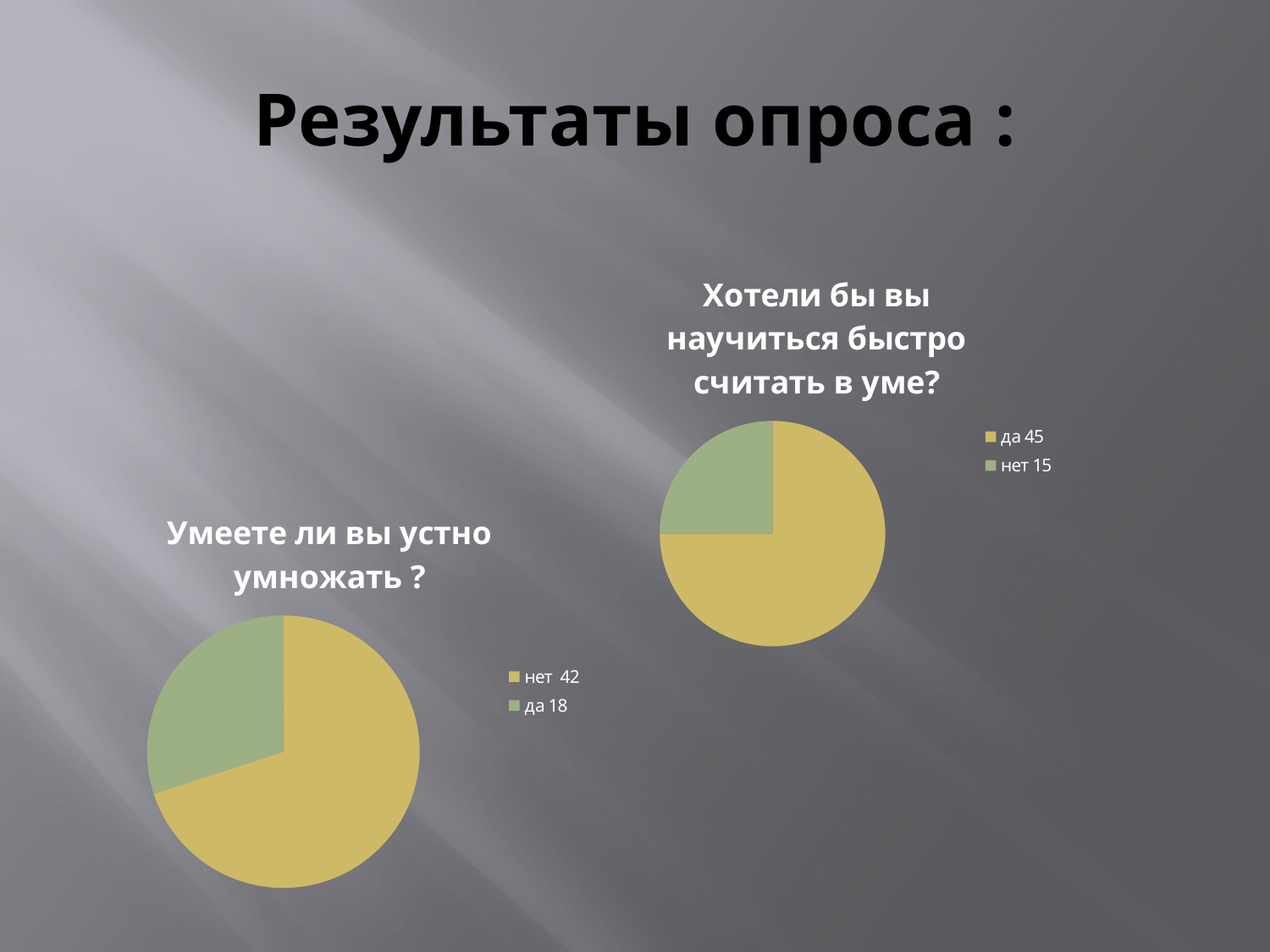
What type of chart is used for "Умеете ли вы устно умножать ?"? pie chart In the chart "Умеете ли вы устно умножать ?", what is the difference between "нет" and "да"? 24 How many slices does the chart "Хотели бы вы научиться быстро считать в уме?" have? 2 In the chart "Хотели бы вы научиться быстро считать в уме?", which answer has the smaller slice? нет In the chart "Умеете ли вы устно умножать ?", what is the value for "да"? 18 In the chart "Хотели бы вы научиться быстро считать в уме?", what is the value for "да"? 45 In the chart "Хотели бы вы научиться быстро считать в уме?", what is the value for "нет"? 15 In the chart "Умеете ли вы устно умножать ?", what share of the pie does "да" represent? 30% In the chart "Хотели бы вы научиться быстро считать в уме?", what share of the pie does "да" represent? 75% Which is larger: "да" in the chart "Хотели бы вы научиться быстро считать в уме?" or "нет" in the chart "Умеете ли вы устно умножать ?"? да in "Хотели бы вы научиться быстро считать в уме?" In the chart "Умеете ли вы устно умножать ?", what is the value for "нет"? 42 In the chart "Умеете ли вы устно умножать ?", which answer has the larger slice? нет